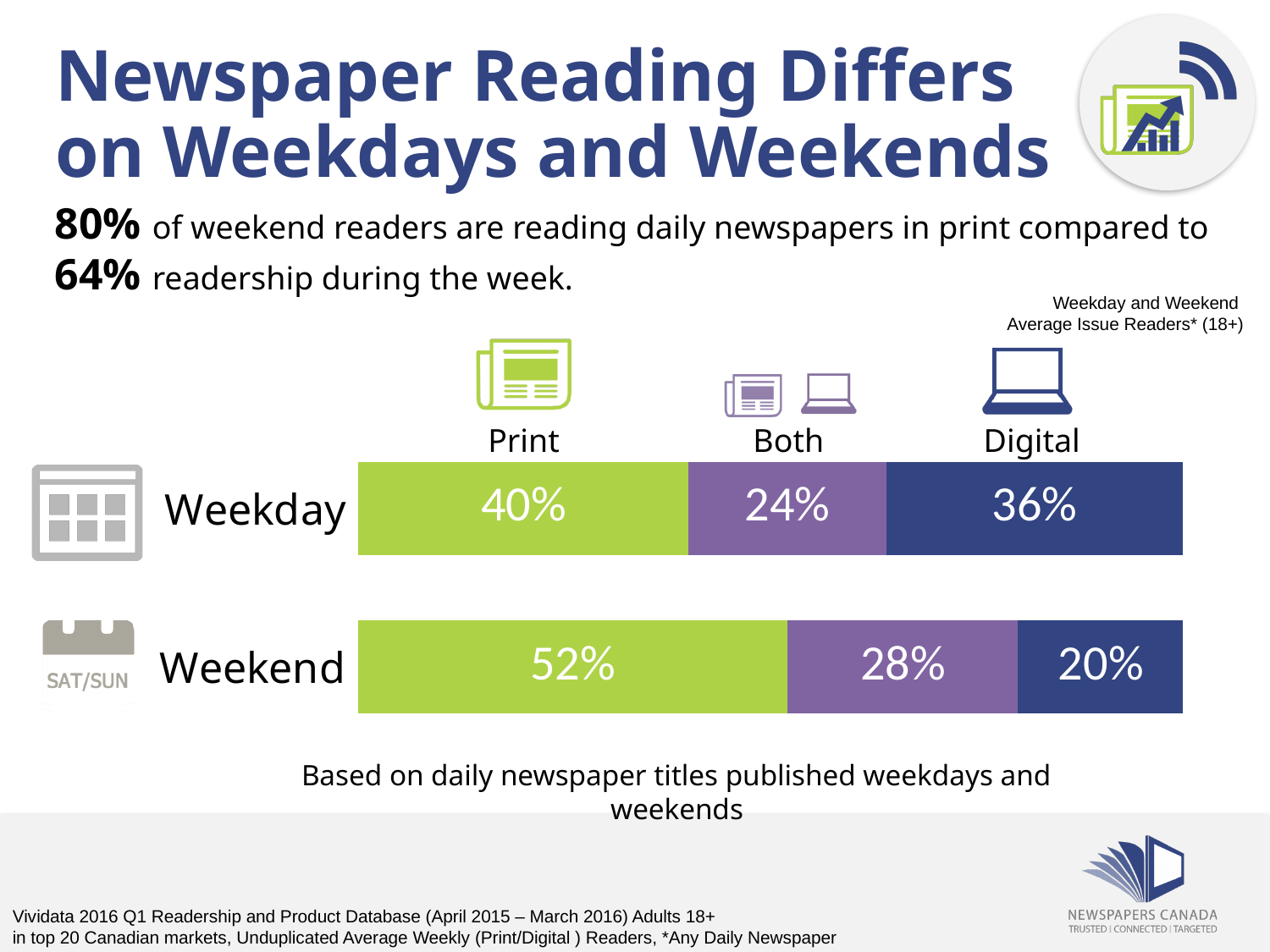
What percentage of Weekday readers read Digital only? 36% What is the total of the Weekday bar's segments? 100% What percentage of Weekend readers read Digital only? 20% What is the difference between the Print share on Weekend and on Weekday? 12% Which segment is the smallest in the Weekday bar? Both What percentage of Weekend readers read Both print and digital? 28% Which segment is the largest in the Weekend bar? Print How many segments does each stacked bar have? 3 What percentage of Weekday readers read in Print? 40% What type of chart is shown on the slide? Stacked bar chart Which is larger: the Digital share on Weekday or on Weekend? Weekday How many bars (rows) are shown in the chart? 2